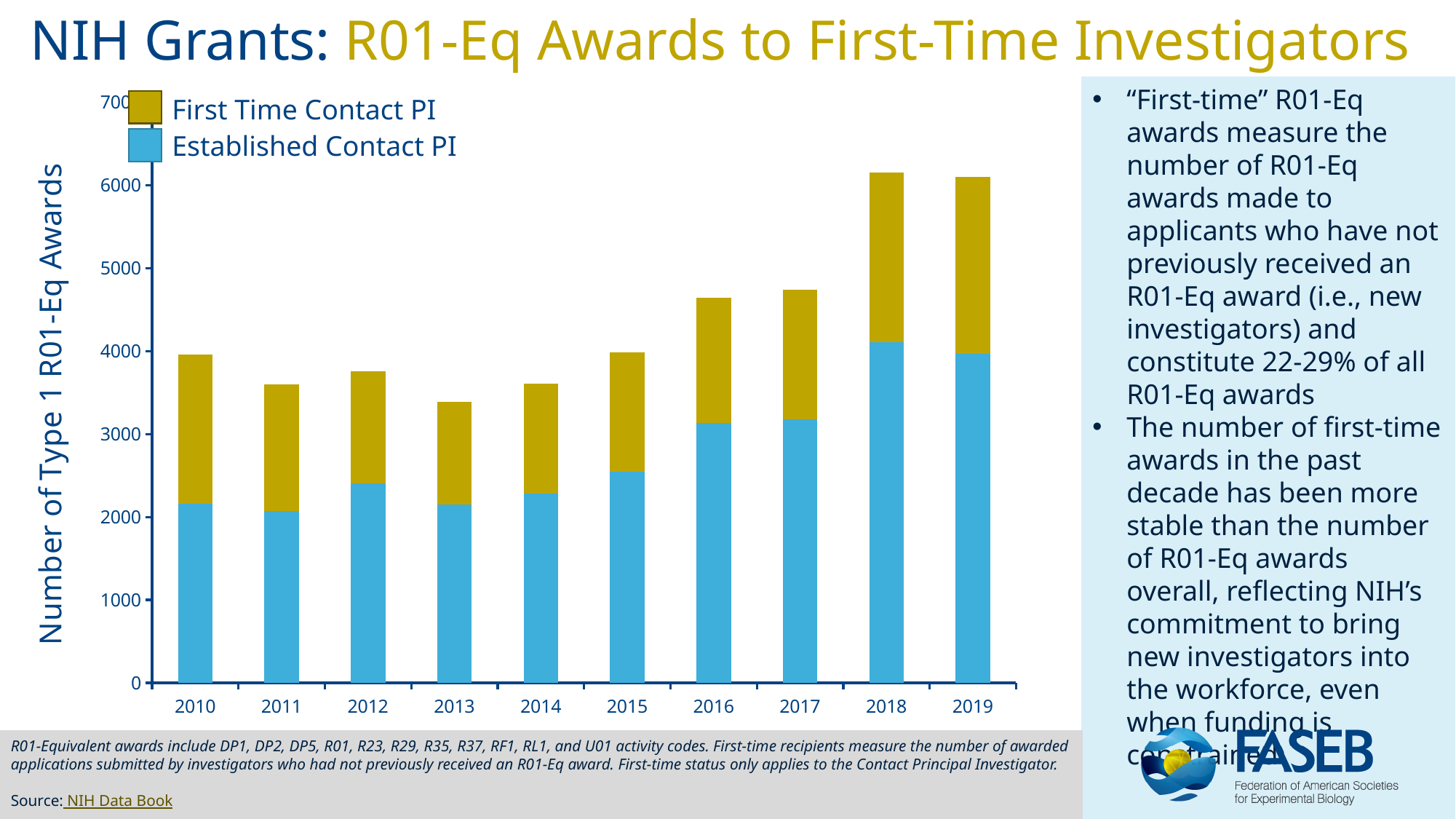
Is the total number of awards in 2016 greater or less than 4000? greater How many years are shown on the x axis of the chart? 10 Is the total number of awards larger in 2018 or in 2013? 2018 What kind of chart is shown on the slide? Stacked bar chart Which year has the lowest total number of Type 1 R01-Eq awards? 2013 Is the number of Established Contact PI awards in 2017 greater or less than 3000? greater Is the total number of awards in 2013 greater or less than 3500? less Which colour represents First Time Contact PI in the chart? Gold How many series does the chart's legend list? 2 Do the total awards rise or fall from 2015 to 2018? rise Which year has the highest number of Established Contact PI awards? 2018